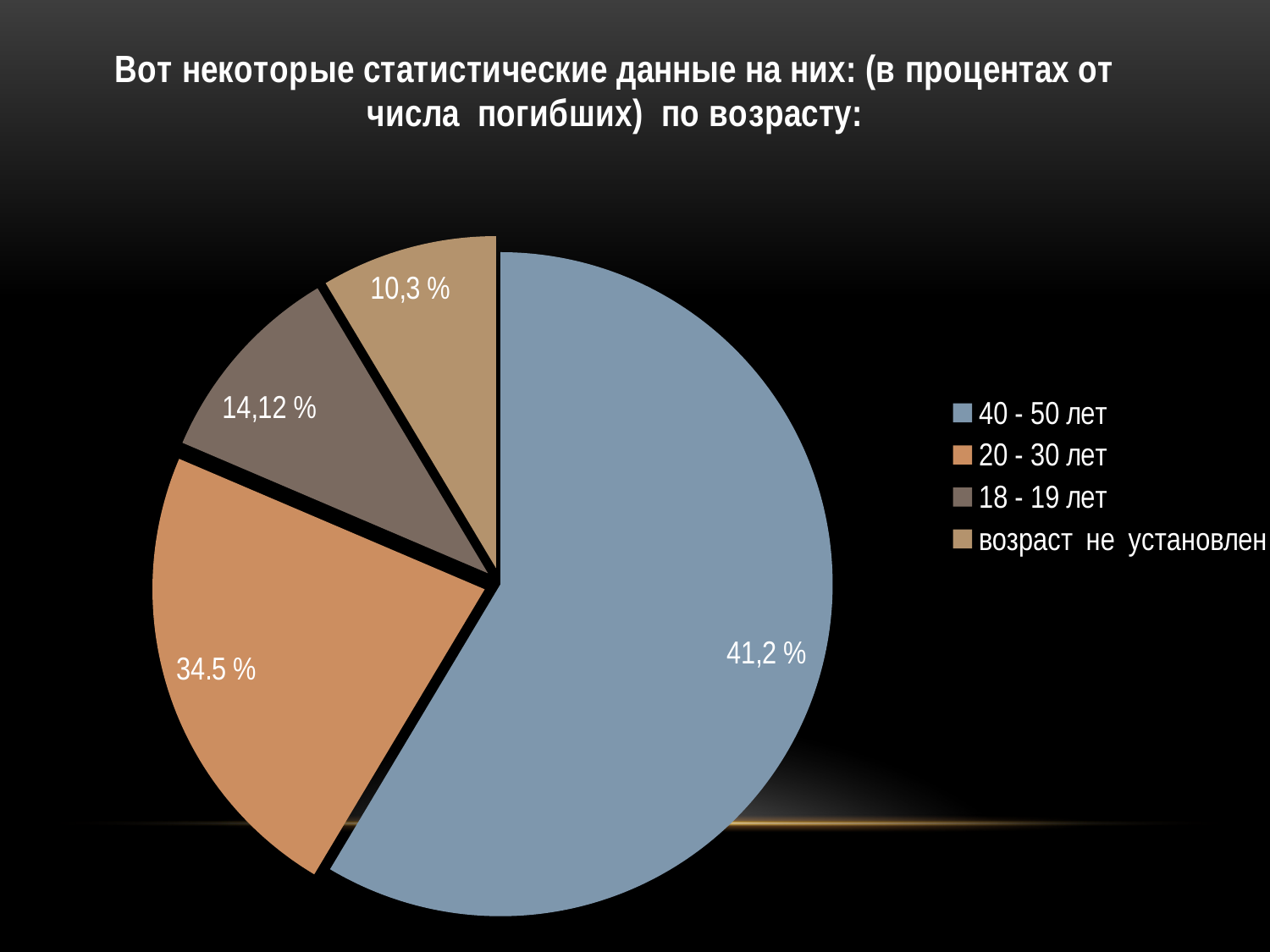
What percentage is shown for the "возраст не установлен" slice? 10,3 % What percentage is shown for the "20 - 30 лет" slice? 34.5 % What percentage is shown for the "40 - 50 лет" slice? 41,2 % Which category has the smallest share of the pie? возраст не установлен What percentage is shown for the "18 - 19 лет" slice? 14,12 % Which slice is larger: "20 - 30 лет" or "18 - 19 лет"? 20 - 30 лет How many entries does the legend list? 4 What kind of chart is shown on the slide? Pie chart How many slices does the pie chart have? 4 Which age category has the largest share of the pie? 40 - 50 лет By how many percentage points does the "40 - 50 лет" slice exceed the "возраст не установлен" slice? 30,9 % What colour is the "40 - 50 лет" slice? Blue (grey-blue)